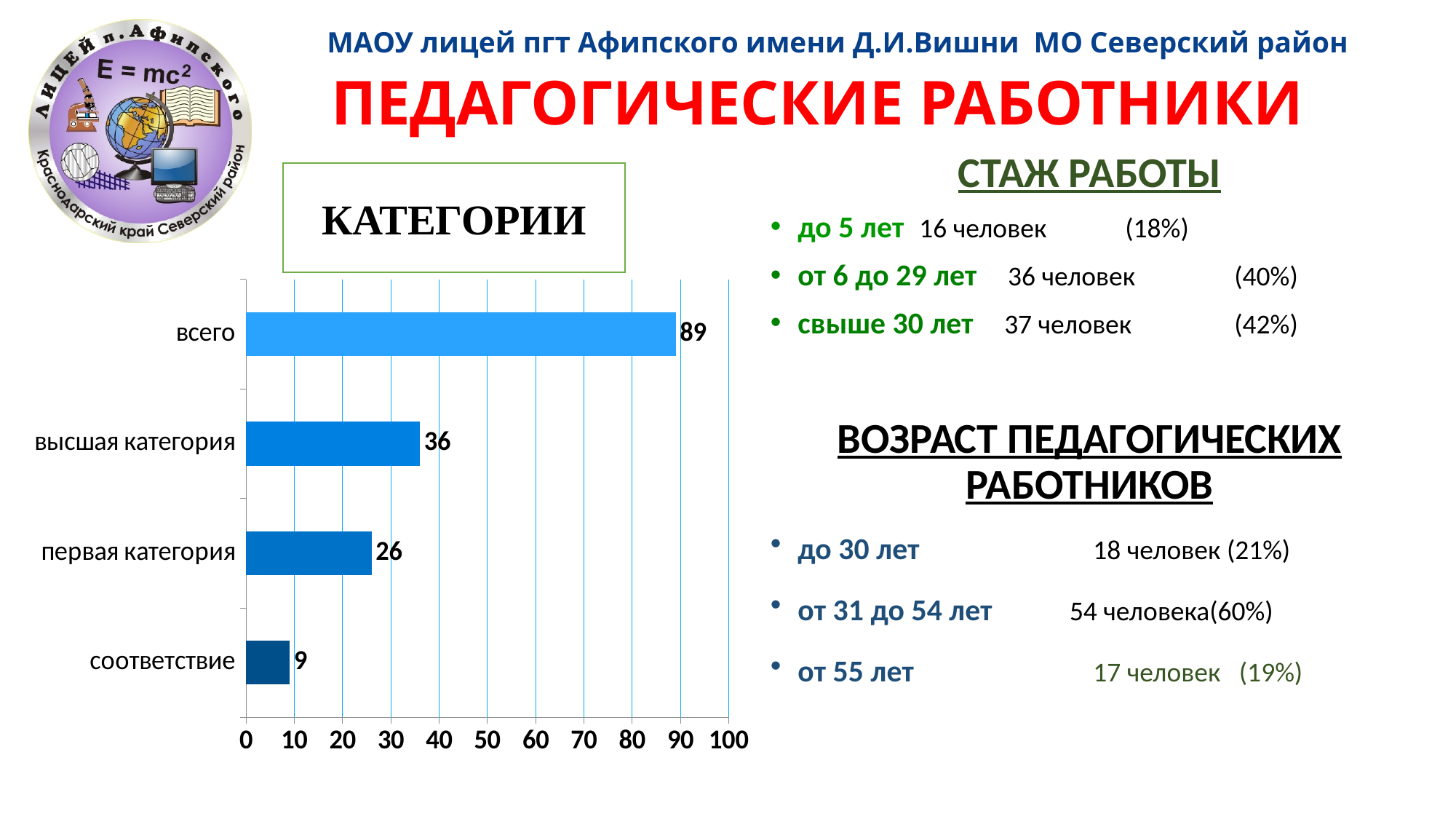
What is the value for высшая категория in the КАТЕГОРИИ chart? 36 Which is larger in the КАТЕГОРИИ chart: первая категория or соответствие? первая категория Which category has the lowest value in the КАТЕГОРИИ chart? соответствие How many categories are shown in the КАТЕГОРИИ chart? 4 What is the value for первая категория in the КАТЕГОРИИ chart? 26 What is the maximum value shown on the x axis of the КАТЕГОРИИ chart? 100 Which category has the highest value in the КАТЕГОРИИ chart? всего What is the difference between the values for высшая категория and первая категория in the КАТЕГОРИИ chart? 10 What is the value for всего in the КАТЕГОРИИ chart? 89 Is the value for всего in the КАТЕГОРИИ chart greater or less than 80? greater What is the value for соответствие in the КАТЕГОРИИ chart? 9 What kind of chart is the КАТЕГОРИИ chart? bar chart